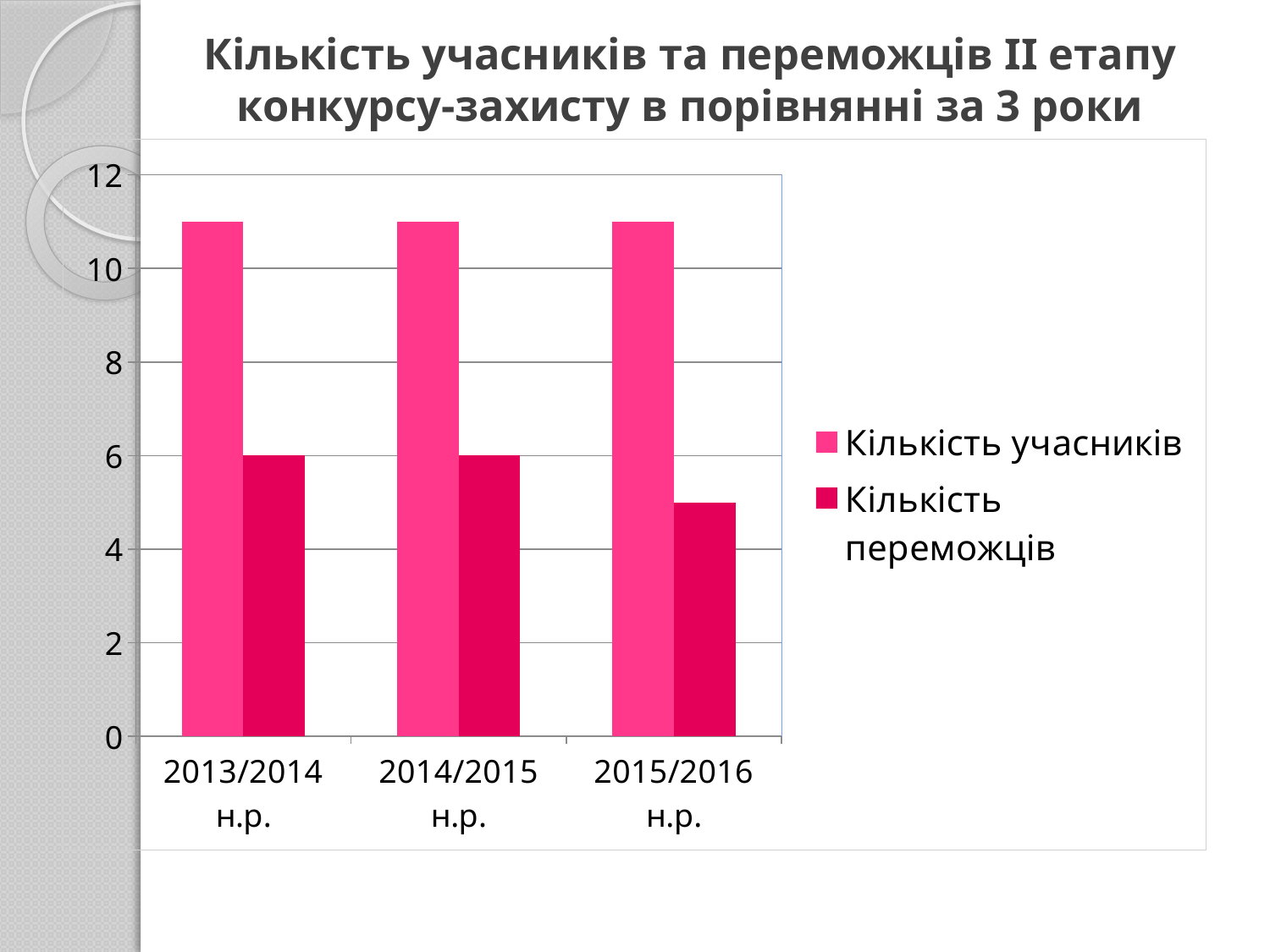
Is the value of Кількість учасників for 2013/2014 н.р. greater or less than 10? greater What is the value of Кількість переможців for 2013/2014 н.р.? 6 Is the value of Кількість учасників for 2015/2016 н.р. greater or less than 12? less Does the Кількість переможців series rise or fall from 2014/2015 н.р. to 2015/2016 н.р.? fall What is the value of Кількість переможців for 2014/2015 н.р.? 6 Is the value of Кількість переможців for 2015/2016 н.р. greater or less than 6? less What kind of chart is shown on the slide? bar chart Which academic year has the lowest value for Кількість переможців? 2015/2016 н.р. How many academic years (categories) are shown on the x axis? 3 How many series does the legend list? 2 Which series is shown in the darker pink colour? Кількість переможців For 2015/2016 н.р., which is larger: Кількість учасників or Кількість переможців? Кількість учасників